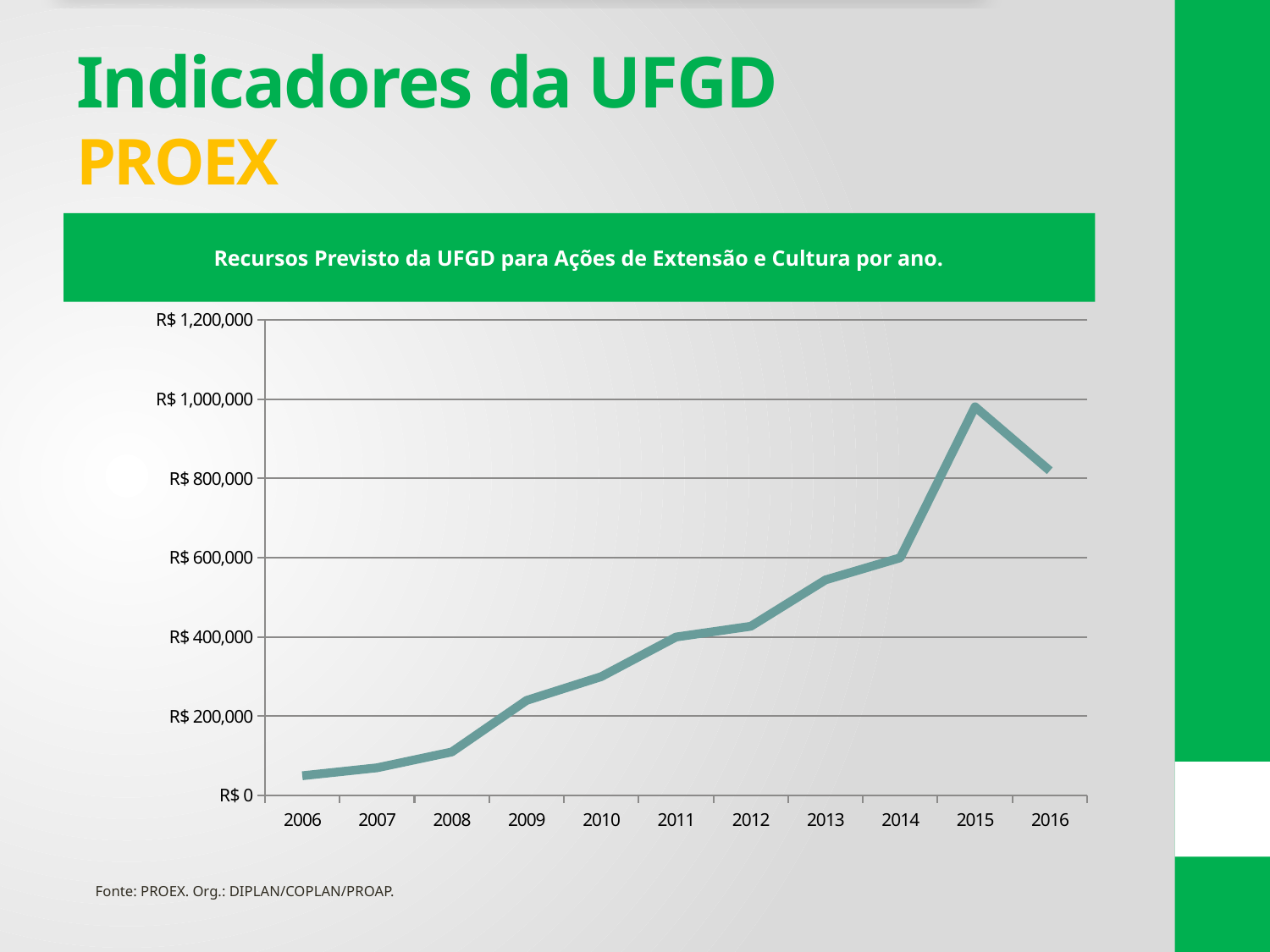
Is the value for 2013 greater or less than R$ 600,000? less Is the value for 2015 greater or less than R$ 800,000? greater Do the values rise or fall from 2006 to 2015? rise Which year has the larger value, 2015 or 2016? 2015 Is the value for 2009 greater or less than R$ 200,000? greater What is the title of the chart? Recursos Previsto da UFGD para Ações de Extensão e Cultura por ano. Which year has the highest value in the chart? 2015 Which year has the lowest value in the chart? 2006 What kind of chart is shown on the slide? line chart How many years are plotted on the x axis of the chart? 11 Which year has the larger value, 2009 or 2013? 2013